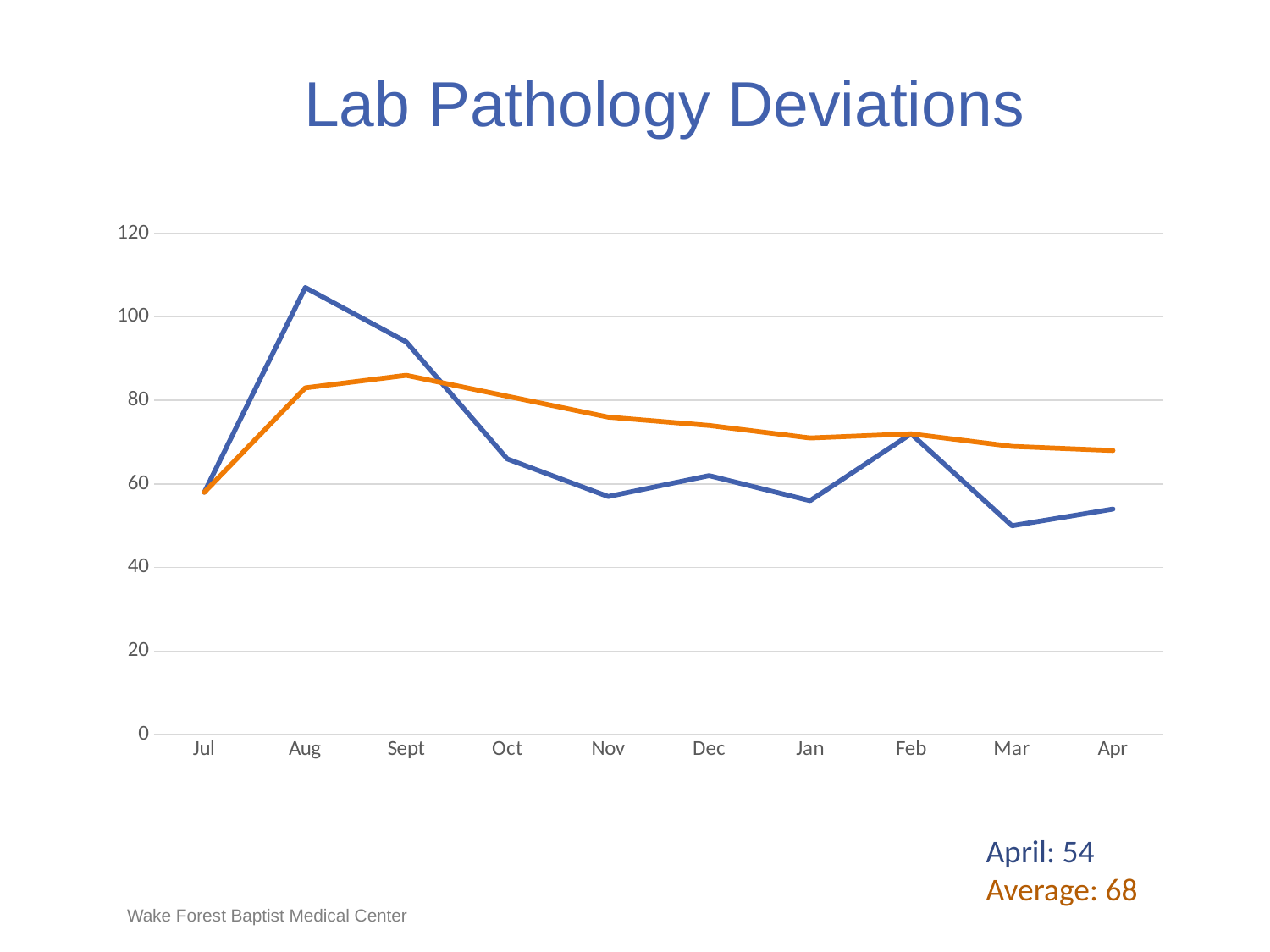
Is the blue line's value for Aug greater or less than 100? greater What is the value of the orange average line for April? 68 How many lines are plotted on the chart? 2 In which month does the blue line reach its lowest value? Mar Does the orange line rise or fall from Sept to Apr? fall What is the title of the chart? Lab Pathology Deviations In Nov, which line is higher, the blue line or the orange line? orange line In which month does the blue line reach its highest value? Aug What kind of chart is shown on the slide? line chart What is the value of the blue line for April? 54 How many months are plotted along the x axis? 10 What is the difference between the average (68) and the April value (54)? 14